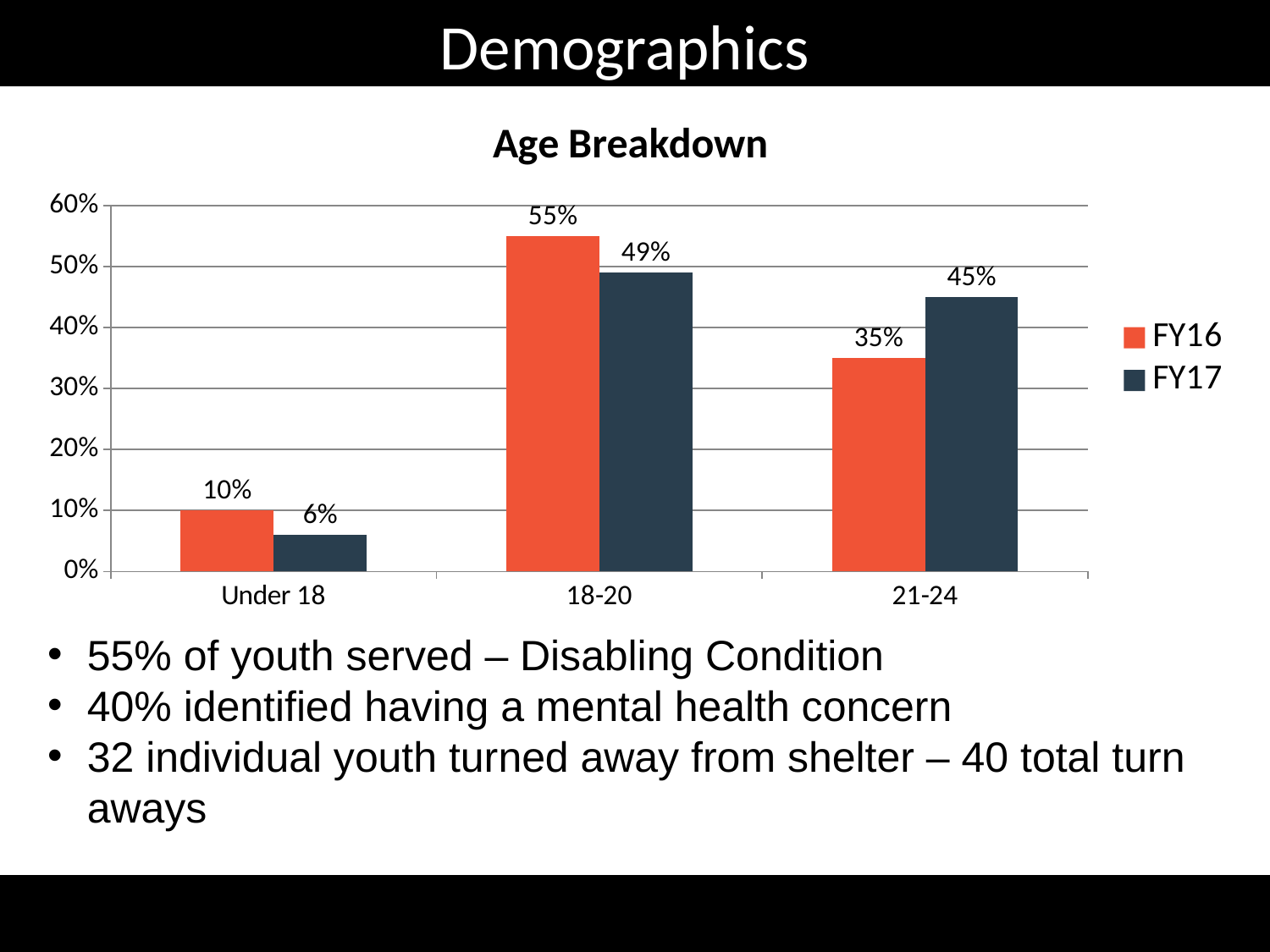
What is the difference between the FY16 values for 18-20 and 21-24? 20% What is the title of the chart? Age Breakdown What is the difference between the FY16 and FY17 values for the 21-24 age group? 10% What is the FY17 value for the Under 18 age group? 6% What is the FY16 value for the 18-20 age group? 55% Which age group has the lowest FY17 value? Under 18 What kind of chart is shown on the slide? Bar chart Which is larger for the 21-24 age group, FY16 or FY17? FY17 What is the FY17 value for the 21-24 age group? 45% How many series does the legend list? 2 How many age groups are shown on the x axis? 3 Which age group has the highest FY16 value? 18-20